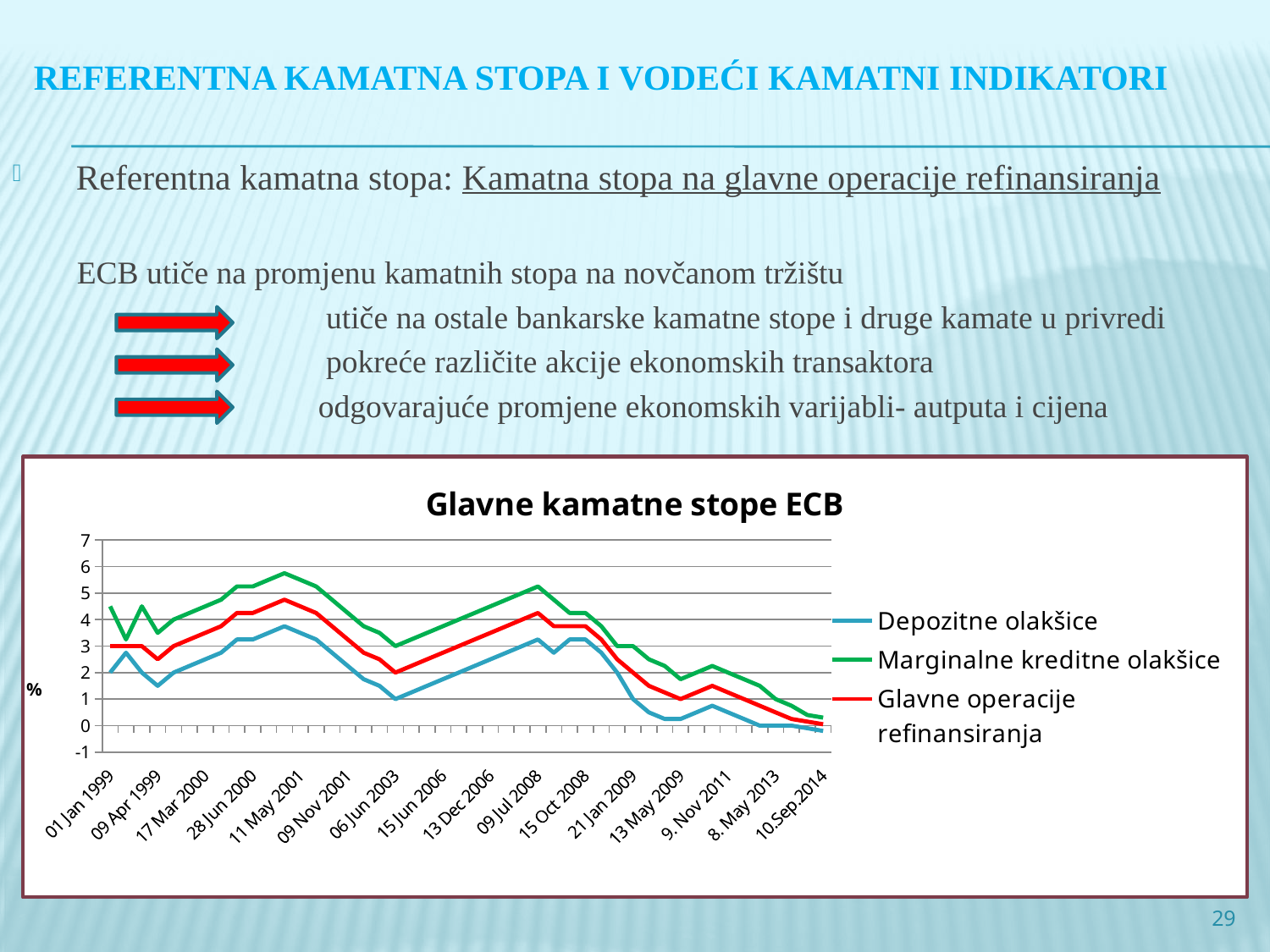
Do the values of Glavne operacije refinansiranja rise or fall from 09 Jul 2008 to 10.Sep.2014? fall Is the value for Glavne operacije refinansiranja at 09 Jul 2008 greater or less than 4? greater Which series is drawn in green in the chart? Marginalne kreditne olakšice Is the value for Depozitne olakšice at 01 Jan 1999 greater or less than 3? less Is the value for Glavne operacije refinansiranja at 10.Sep.2014 greater or less than 1? less How many series does the legend of the chart list? 3 Which series has the highest values across the whole chart? Marginalne kreditne olakšice What is the title of the chart? Glavne kamatne stope ECB What kind of chart is shown on the slide? line chart At 11 May 2001, which is higher: Marginalne kreditne olakšice or Depozitne olakšice? Marginalne kreditne olakšice